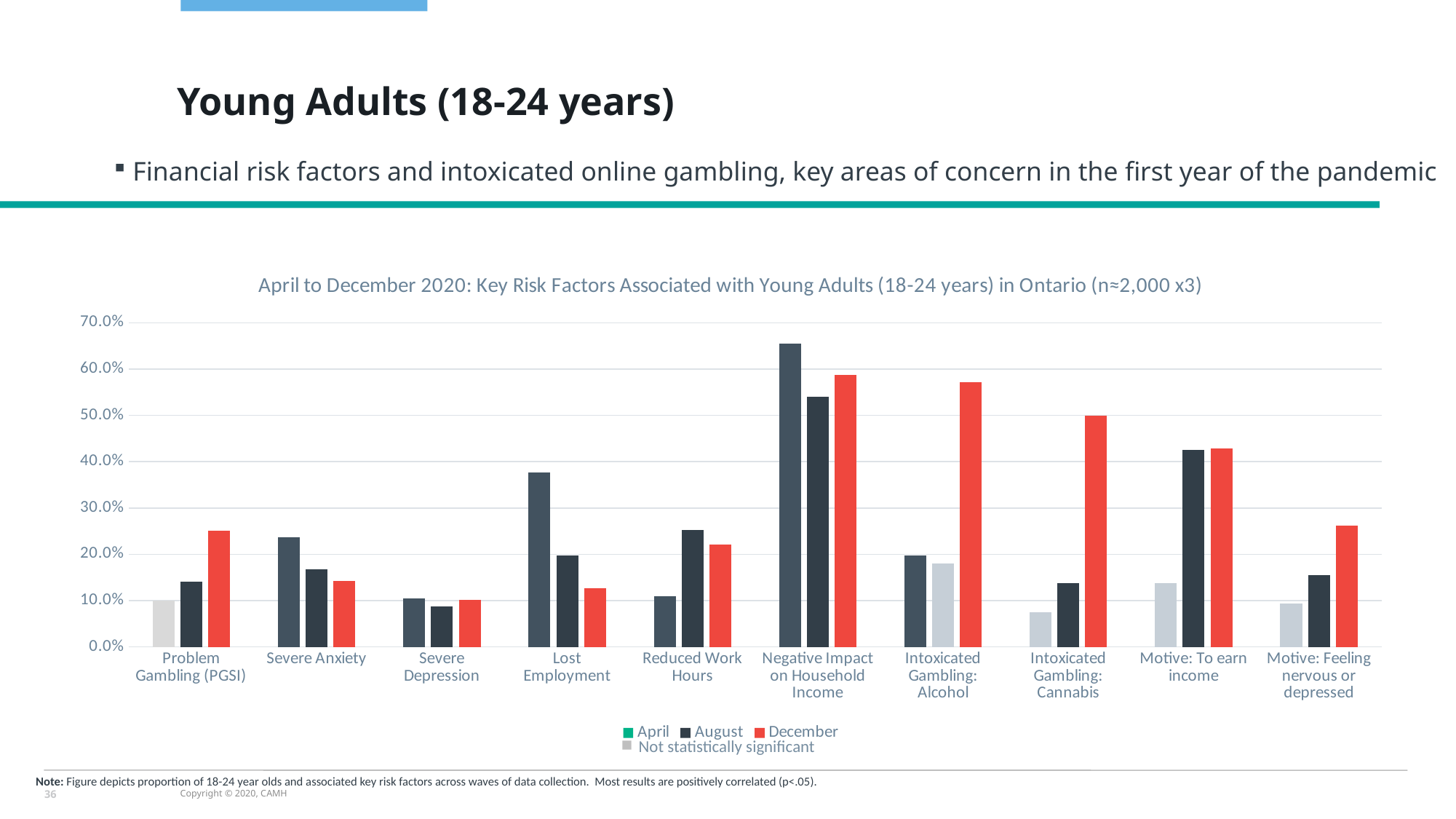
Which category has the tallest bar in the chart? Negative Impact on Household Income Is the April value for Lost Employment greater or less than 30.0%? greater Do the values for Lost Employment rise or fall from April to December? Fall Do the values for Intoxicated Gambling: Cannabis rise or fall from April to December? Rise How many entries does the legend list? 4 How many risk factor categories are shown along the x axis? 10 What is the title of the chart? April to December 2020: Key Risk Factors Associated with Young Adults (18-24 years) in Ontario (n≈2,000 x3) For Lost Employment, which is larger: the April value or the December value? April What kind of chart is shown on the slide? Bar chart Is the December value for Intoxicated Gambling: Alcohol greater or less than 50.0%? greater Is the August value for Negative Impact on Household Income greater or less than 50.0%? greater For Problem Gambling (PGSI), which is larger: the August value or the December value? December